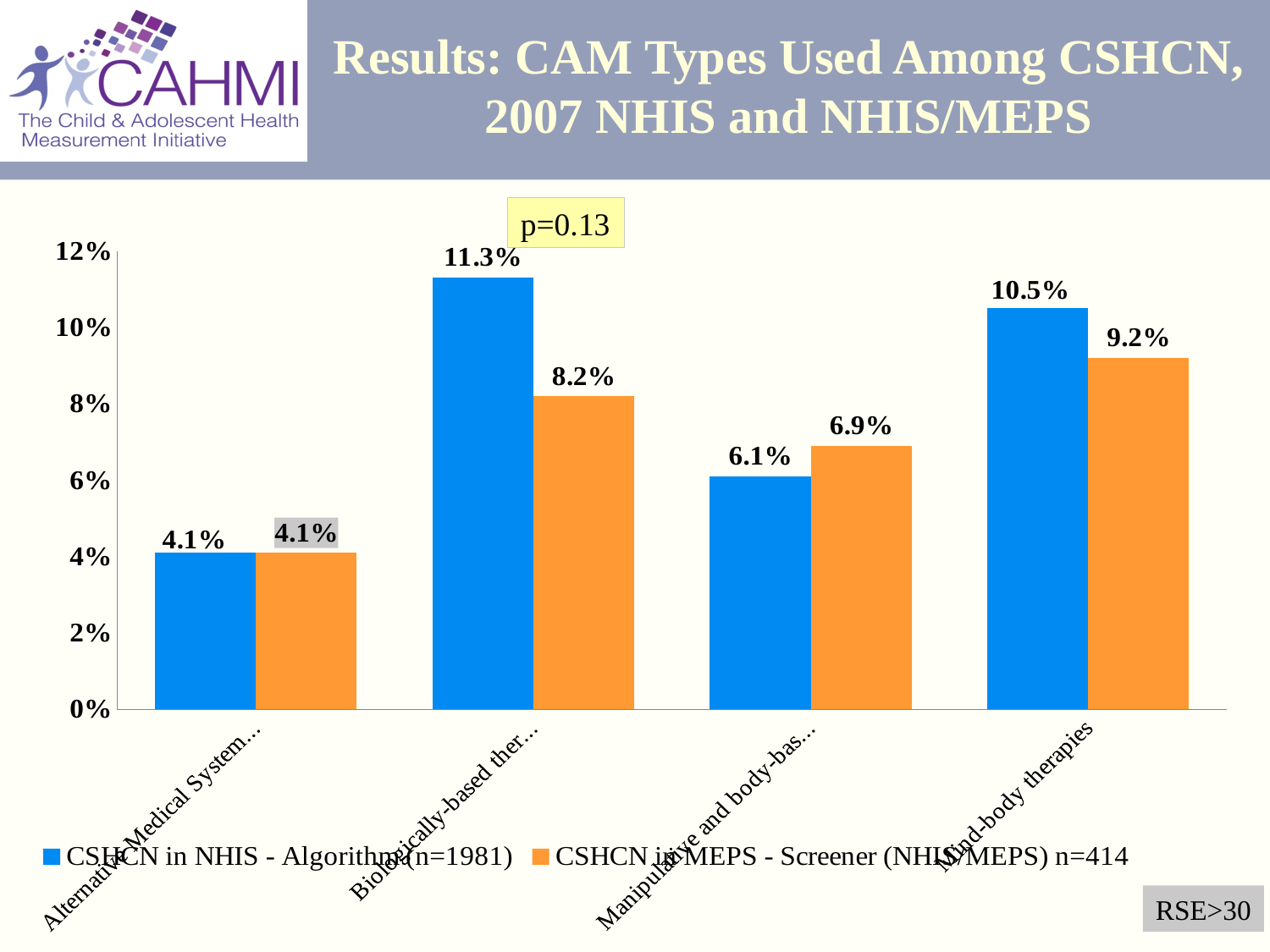
What type of chart is shown on the slide? bar chart What is the value for Mind-body therapies in the CSHCN in MEPS - Screener (NHIS/MEPS) n=414 series? 9.2% Which category has the lowest value in the CSHCN in MEPS - Screener (NHIS/MEPS) n=414 series? Alternative Medical System How many series does the legend list? 2 What p-value is annotated above the Biologically-based therapies bars? p=0.13 For the Manipulative and body-based category, which series has the larger value? CSHCN in MEPS - Screener (NHIS/MEPS) n=414 What is the value for the Manipulative and body-based category in the CSHCN in MEPS - Screener (NHIS/MEPS) n=414 series? 6.9% What is the value for the Biologically-based therapies category in the CSHCN in NHIS - Algorithm (n=1981) series? 11.3% How many CAM type categories are shown on the x axis? 4 What is the difference between the two series for the Biologically-based therapies category? 3.1% Which category has the highest value in the CSHCN in NHIS - Algorithm (n=1981) series? Biologically-based therapies What is the value for Mind-body therapies in the CSHCN in NHIS - Algorithm (n=1981) series? 10.5%